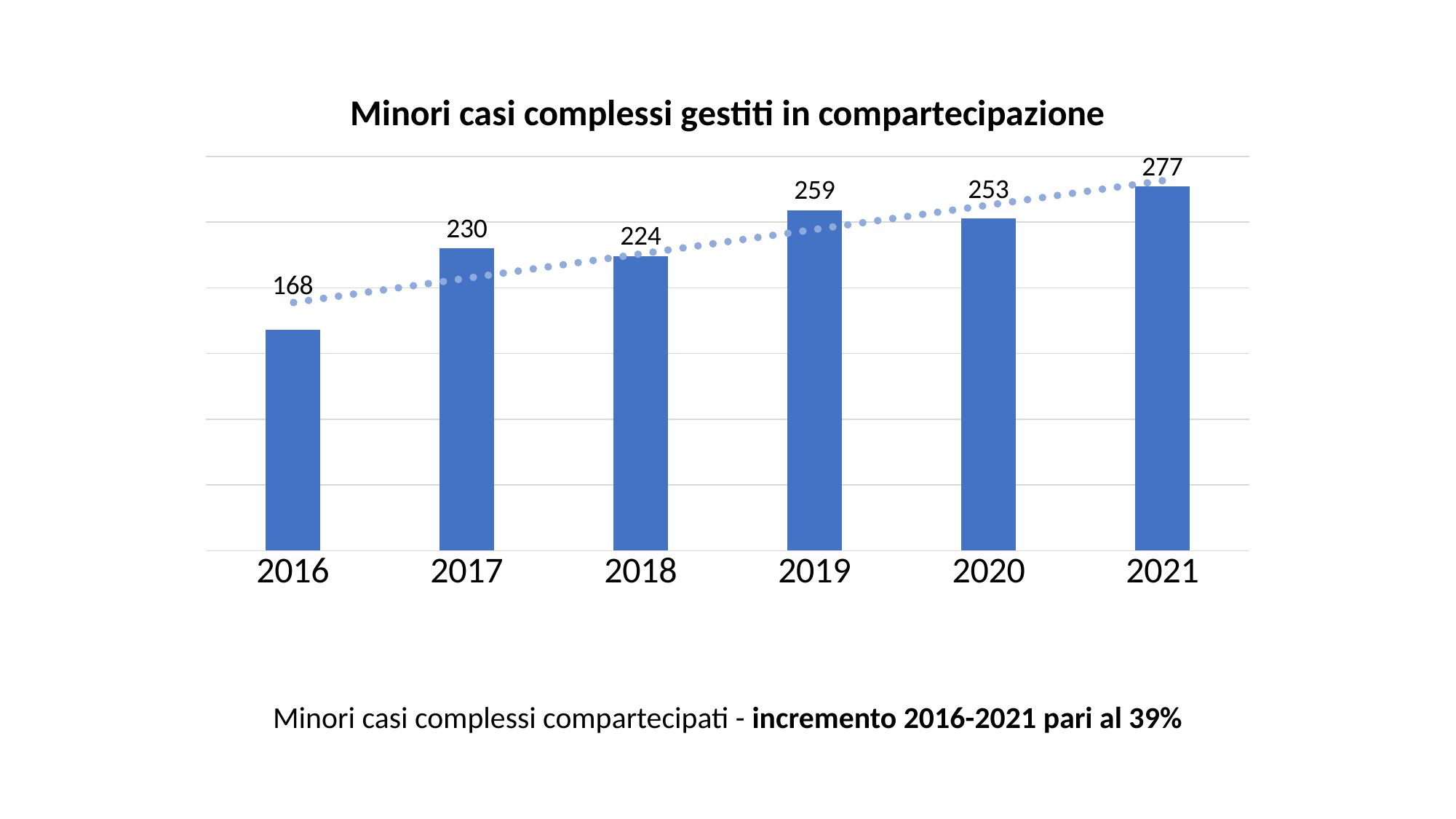
Which is larger, the value for 2017 or the value for 2018? 2017 How many years are shown on the x axis? 6 What is the value for 2016? 168 What kind of chart is this? bar chart What is the value for 2019? 259 What is the difference between the values for 2019 and 2020? 6 What is the value for 2021? 277 Which year has the highest value? 2021 Do the values generally rise or fall from 2016 to 2021? rise What is the title of the chart? Minori casi complessi gestiti in compartecipazione Which year has the lowest value? 2016 What is the difference between the values for 2021 and 2016? 109